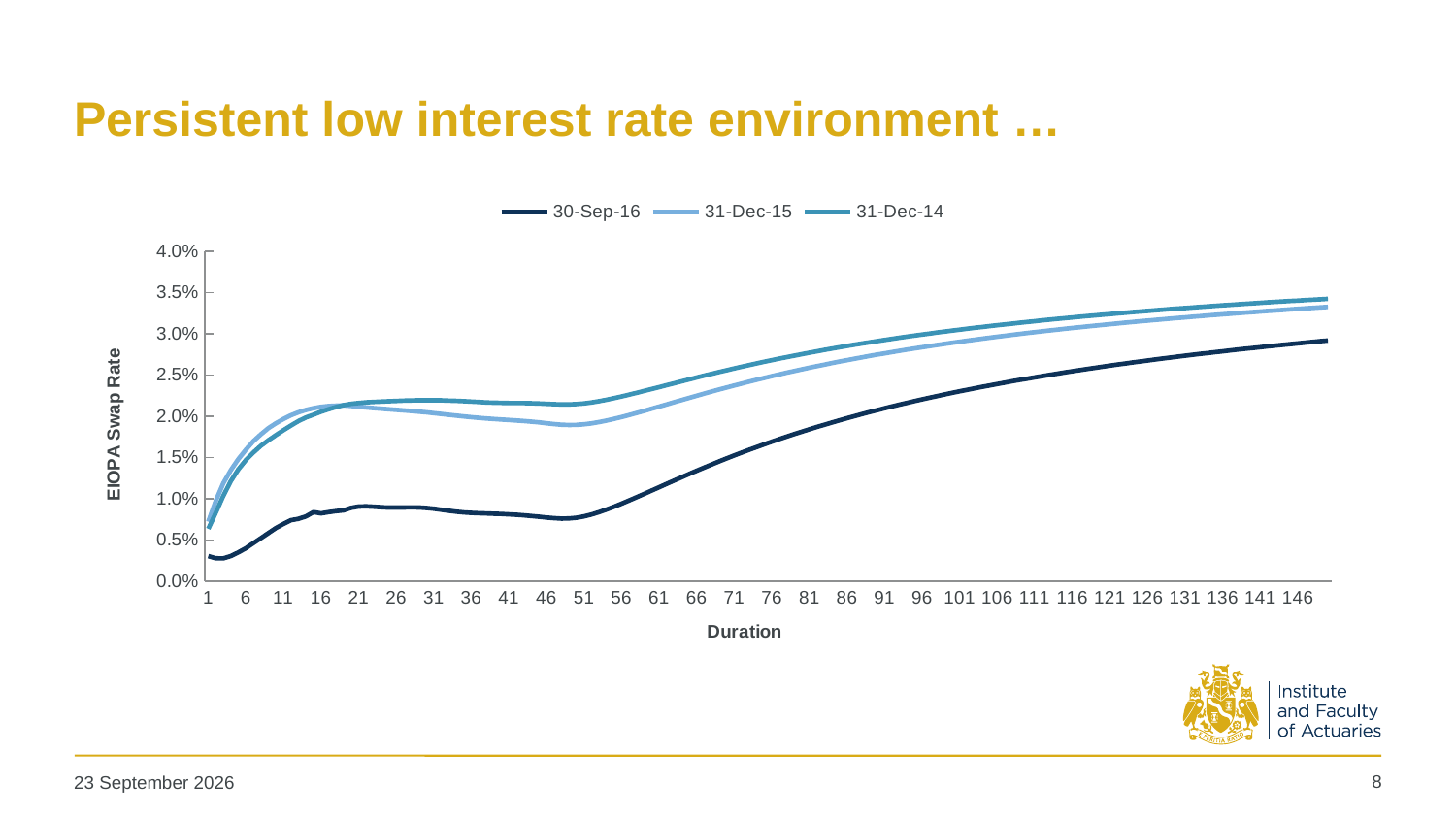
What is the title of the vertical axis? EIOPA Swap Rate How many series does the legend list? 3 What are the three series named in the legend? 30-Sep-16, 31-Dec-15, 31-Dec-14 Is the value for 31-Dec-14 at duration 146 greater or less than 3.0%? greater Does the 31-Dec-15 series rise or fall between duration 21 and duration 51? fall Is the value for 30-Sep-16 at duration 146 greater or less than 2.5%? greater What kind of chart is shown on the slide? line chart Is the value for 30-Sep-16 at duration 51 greater or less than 1.0%? less Does the 30-Sep-16 series rise or fall between duration 56 and duration 146? rise At duration 146, which is higher: 31-Dec-14 or 30-Sep-16? 31-Dec-14 At duration 146, which series has the lowest value? 30-Sep-16